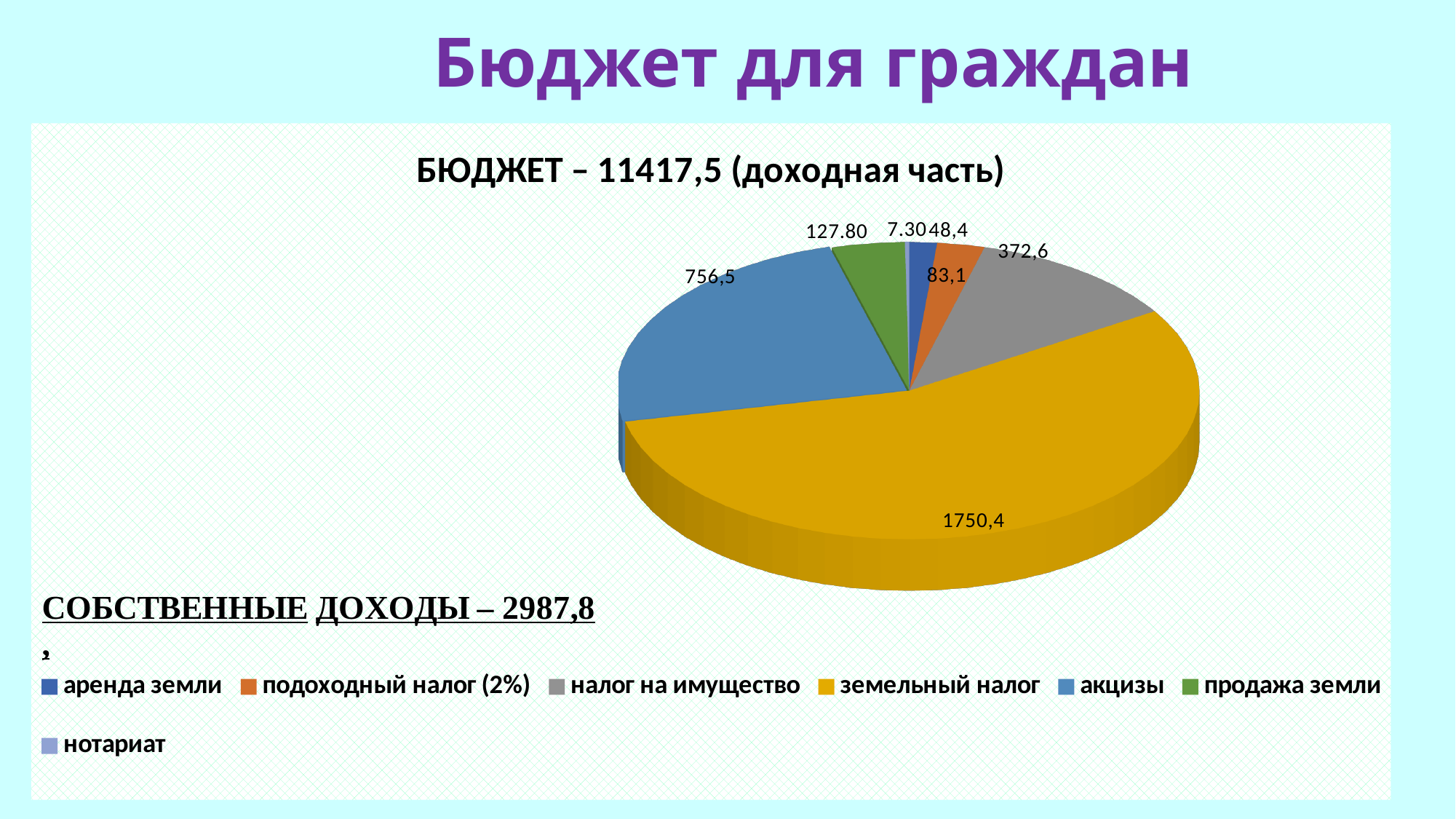
Which is larger, the value for акцизы or the value for налог на имущество? акцизы What colour is the slice for земельный налог? Yellow What is the value shown for акцизы? 756,5 What is the title of the pie chart? БЮДЖЕТ – 11417,5 (доходная часть) What is the value shown for продажа земли? 127.80 How many categories does the legend of the pie chart list? 7 Which category has the largest slice in the pie chart? земельный налог What is the value shown for земельный налог? 1750,4 What is the difference between the values for земельный налог and акцизы? 993,9 What kind of chart is shown on the slide? Pie chart Which category has the smallest slice in the pie chart? нотариат What is the value shown for налог на имущество? 372,6